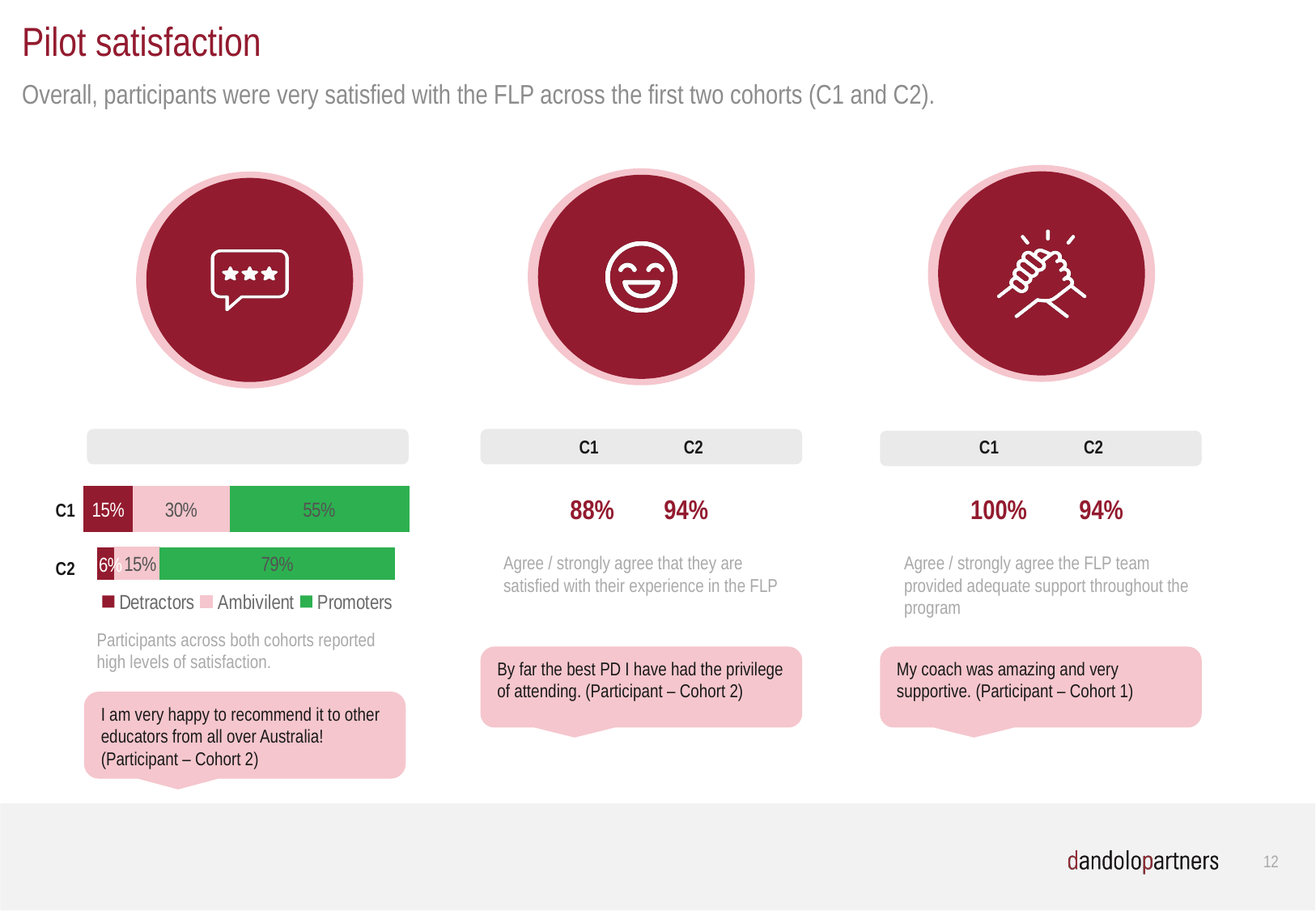
In the stacked bar chart on the left, what is the difference in the Promoters share between C2 and C1? 24% In the stacked bar chart on the left, what percentage of C2 participants were Promoters? 79% In the stacked bar chart on the left, what percentage of C1 participants were Promoters? 55% How many series does the legend of the stacked bar chart on the left list? 3 In the stacked bar chart on the left, what is the difference in the Ambivilent share between C1 and C2? 15% In the stacked bar chart on the left, what percentage of C1 participants were Ambivilent? 30% What type of chart is shown on the left of the slide? Stacked bar chart In the stacked bar chart on the left, which cohort has the lower share of Detractors? C2 In the stacked bar chart on the left, what percentage of C2 participants were Detractors? 6% In the stacked bar chart on the left, which cohort has the higher share of Promoters? C2 In the stacked bar chart on the left, what is the total of the C1 bar? 100% How many cohorts are plotted in the stacked bar chart on the left? 2